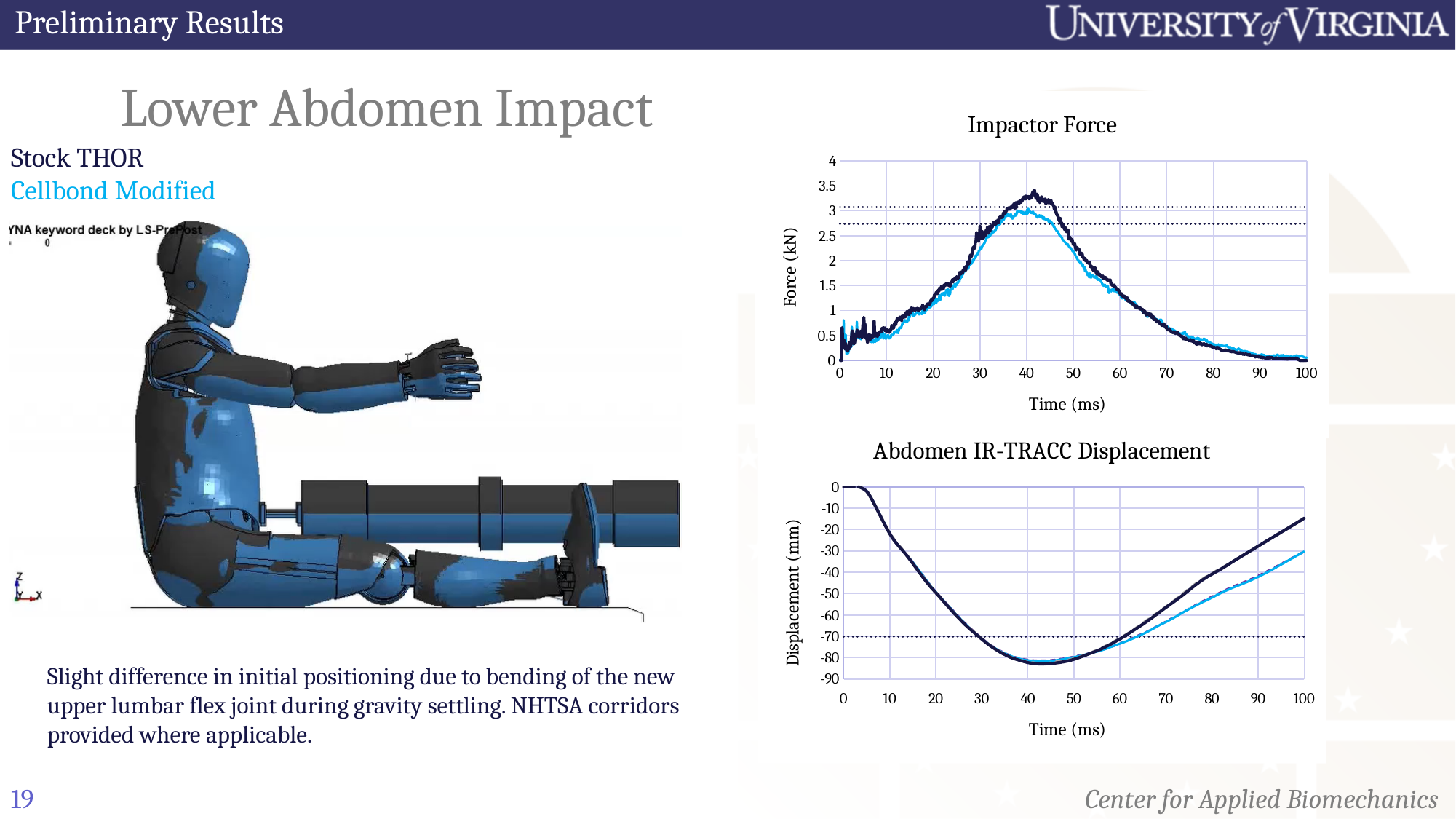
In the Impactor Force chart, what is the label of the y axis? Force (kN) In the Abdomen IR-TRACC Displacement chart, what is the label of the x axis? Time (ms) In the Impactor Force chart, is the peak force of the Stock THOR (dark) curve greater or less than 3 kN? greater In the Abdomen IR-TRACC Displacement chart, is the Stock THOR (dark) displacement at 100 ms greater or less than -20 mm? greater In the Impactor Force chart, is the peak force of the Cellbond Modified (light blue) curve greater or less than 2.5 kN? greater In the Impactor Force chart, does the force rise or fall between 60 ms and 100 ms? fall How many charts are shown on the slide? 2 What type of chart is the Abdomen IR-TRACC Displacement chart? line chart What type of chart is the Impactor Force chart? line chart In the Abdomen IR-TRACC Displacement chart, which series has the displacement closer to zero at 100 ms, Stock THOR or Cellbond Modified? Stock THOR In the Impactor Force chart, which series reaches the higher peak force, Stock THOR or Cellbond Modified? Stock THOR